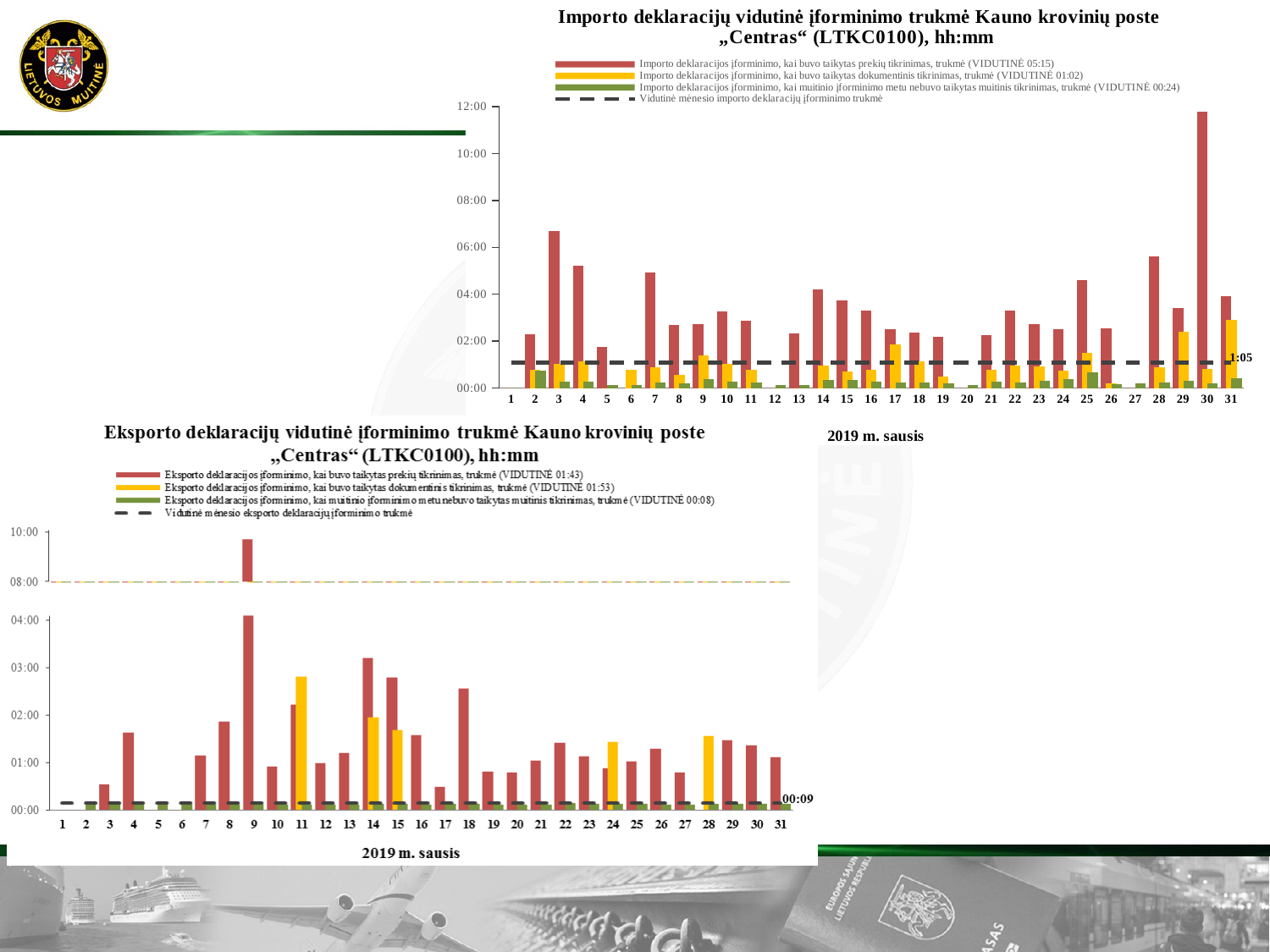
What kind of chart is the top chart, "Importo deklaracijų vidutinė įforminimo trukmė"? bar chart In the top chart (Importo deklaracijų), what value is labelled on the dashed monthly average line? 1:05 In the top chart (Importo deklaracijų), is the red bar for day 30 greater or less than 10:00? greater In the bottom chart (Eksporto deklaracijų), what value is labelled on the dashed monthly average line? 00:09 In the bottom chart (Eksporto deklaracijų), which yellow bar is taller, day 11 or day 14? day 11 In the top chart (Importo deklaracijų), which red bar is taller, day 3 or day 4? day 3 In the top chart (Importo deklaracijų), on which day is the red bar (prekių tikrinimas) the highest? 30 In the top chart (Importo deklaracijų), is the red bar for day 3 greater or less than 06:00? greater In the bottom chart (Eksporto deklaracijų), on which day is the red bar (prekių tikrinimas) the highest? 9 In the top chart (Importo deklaracijų), how many entries does the legend list? 4 In the bottom chart (Eksporto deklaracijų), what average value does the legend give for the yellow series (dokumentinis tikrinimas)? 01:53 In the top chart (Importo deklaracijų), how many days are shown on the x axis? 31